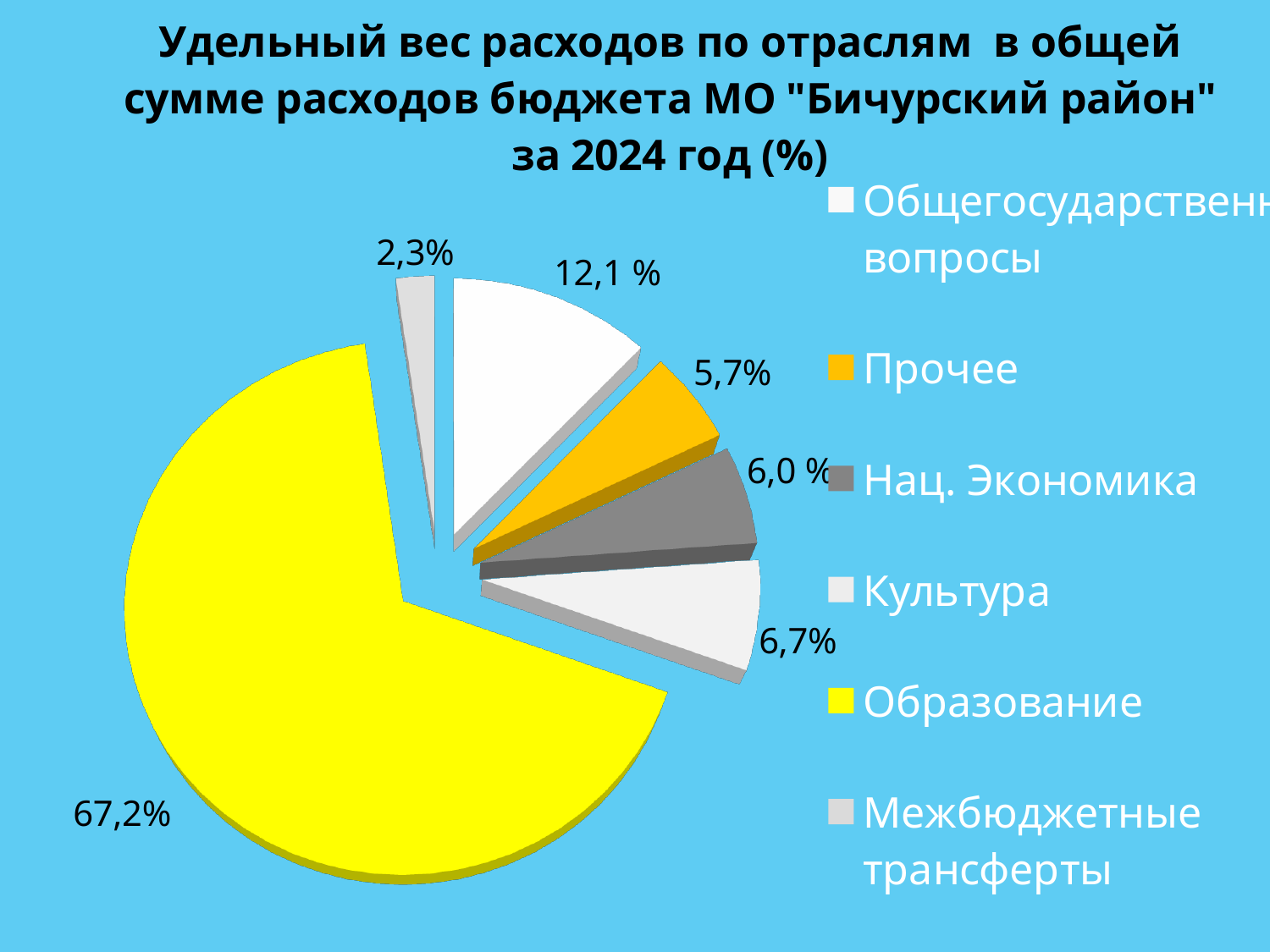
How many slices does the pie chart have? 6 Which category has the largest share of the pie? Образование What is the value shown for Культура? 6,7% What kind of chart is shown on the slide? pie chart How many entries does the legend list? 6 What is the value shown for Прочее? 5,7% Which category has the smallest share of the pie? Межбюджетные трансферты What is the value shown for Межбюджетные трансферты? 2,3% What share of expenditures does Образование account for? 67,2% Which is larger, the share for Культура or the share for Прочее? Культура What is the difference between the shares of Образование and Общегосударственные вопросы? 55,1% What is the value shown for Нац. Экономика? 6,0 %